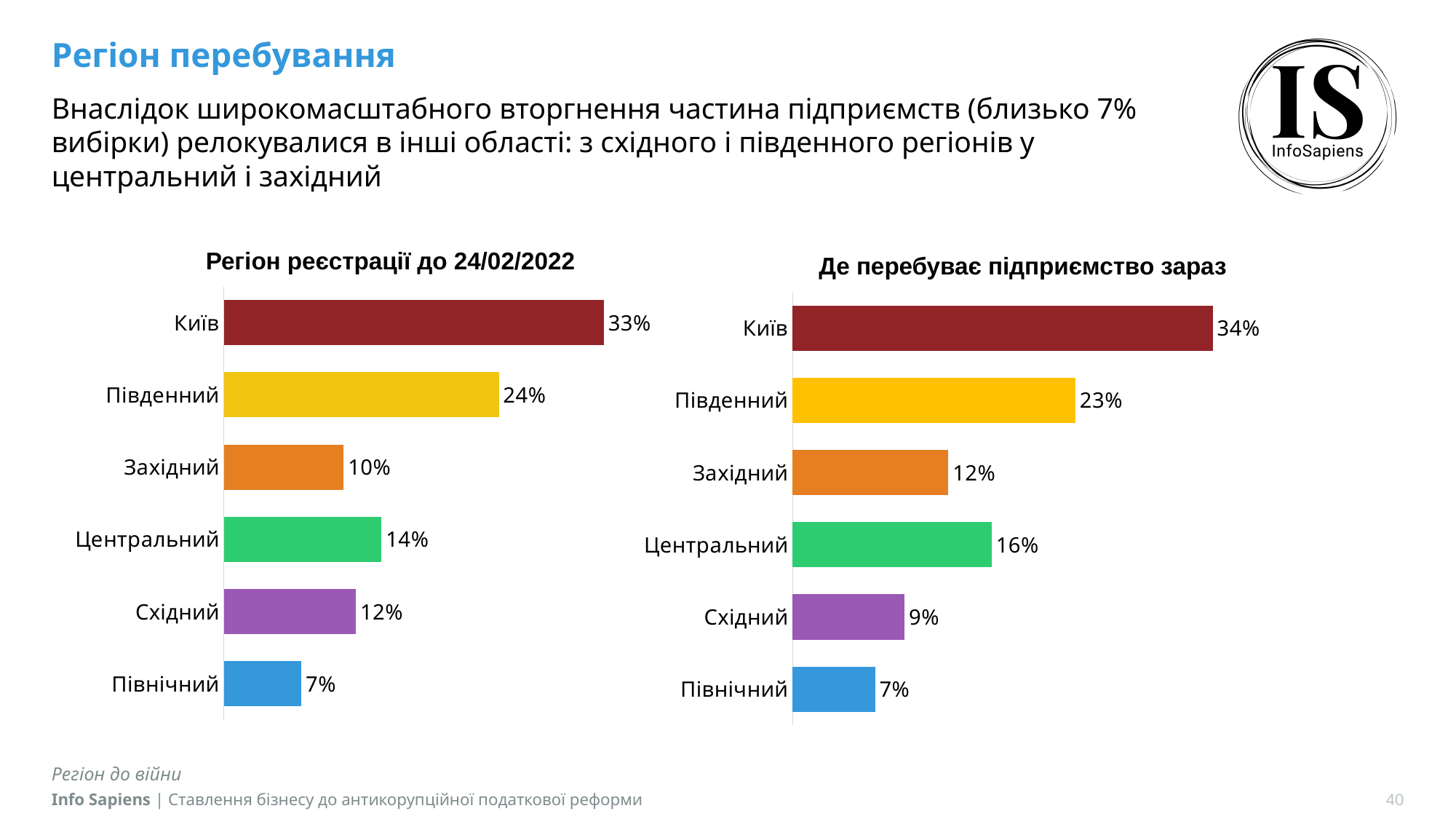
In the chart 'Регіон реєстрації до 24/02/2022', which category has the lowest value? Північний In the chart 'Де перебуває підприємство зараз', which category has the highest value? Київ In the chart 'Регіон реєстрації до 24/02/2022', what is the difference between the values for Південний and Західний? 14% In the chart 'Де перебуває підприємство зараз', what is the difference between the values for Київ and Південний? 11% In the chart 'Де перебуває підприємство зараз', which is larger: the value for Західний or the value for Східний? Західний In the chart 'Регіон реєстрації до 24/02/2022', what is the value for Київ? 33% What is the title of the chart on the right side of the slide? Де перебуває підприємство зараз How many categories are shown in the chart 'Де перебуває підприємство зараз'? 6 What kind of chart is 'Регіон реєстрації до 24/02/2022'? Bar chart In the chart 'Регіон реєстрації до 24/02/2022', what is the value for Східний? 12% In the chart 'Регіон реєстрації до 24/02/2022', which is larger: the value for Центральний or the value for Західний? Центральний In the chart 'Де перебуває підприємство зараз', what is the value for Центральний? 16%